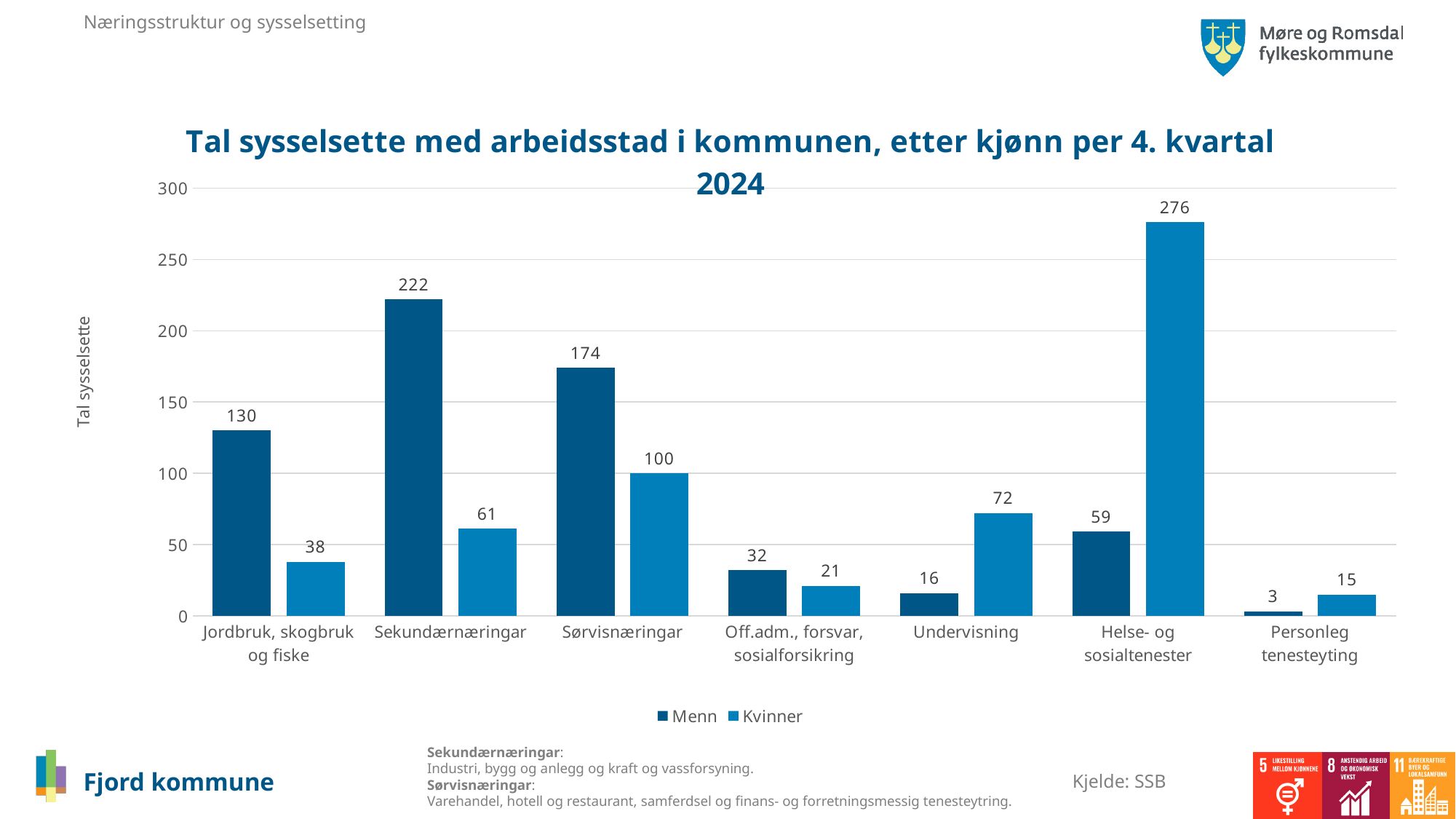
What is the value for Kvinner in Helse- og sosialtenester? 276 How many series does the legend list? 2 What is the value for Kvinner in Undervisning? 72 How many categories are shown on the x axis? 7 What is the value for Menn in Sekundærnæringar? 222 Is the value for Kvinner in Sørvisnæringar greater or less than 150? less Which category has the lowest value for Kvinner? Personleg tenesteyting Which is larger in Jordbruk, skogbruk og fiske: Menn or Kvinner? Menn What kind of chart is shown on the slide? bar chart Which category has the highest value for Menn? Sekundærnæringar What is the difference between Menn and Kvinner in Sørvisnæringar? 74 What is the source cited for the chart? SSB